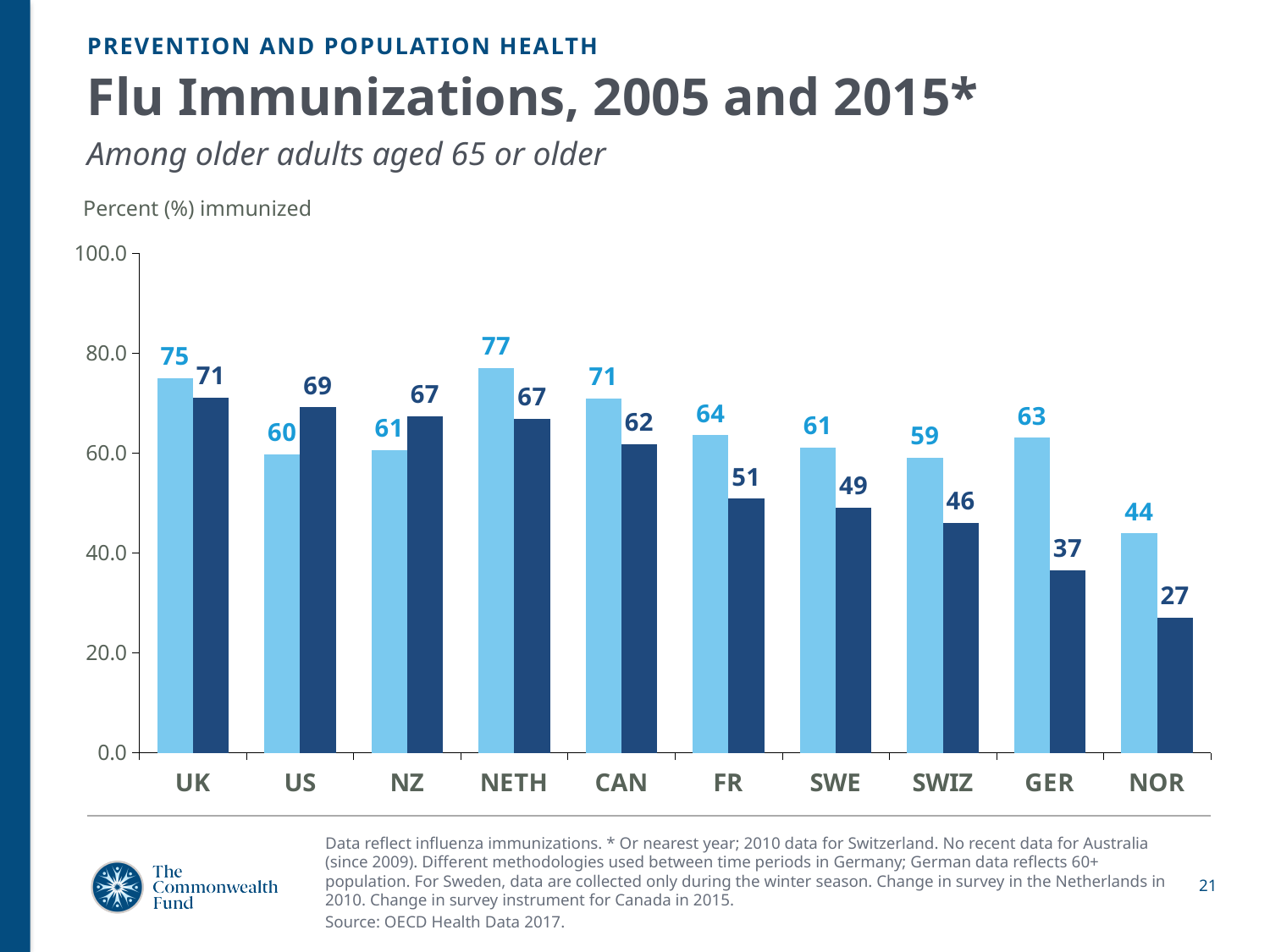
Do the dark blue bars rise or fall from left to right across the countries? fall Which country has the lowest dark blue bar? NOR What is the value of the dark blue bar for FR? 51 For US, which bar is larger, the light blue or the dark blue? dark blue Is the value of the dark blue bar for NOR greater or less than 40? less How many countries are shown on the x axis? 10 Which country has the highest light blue bar? NETH What is the difference between the light blue and dark blue bars for GER? 26 What is the value of the dark blue bar for GER? 37 What kind of chart is shown on the slide? bar chart What is the difference between the light blue and dark blue bars for UK? 4 What is the value of the light blue bar for NETH? 77